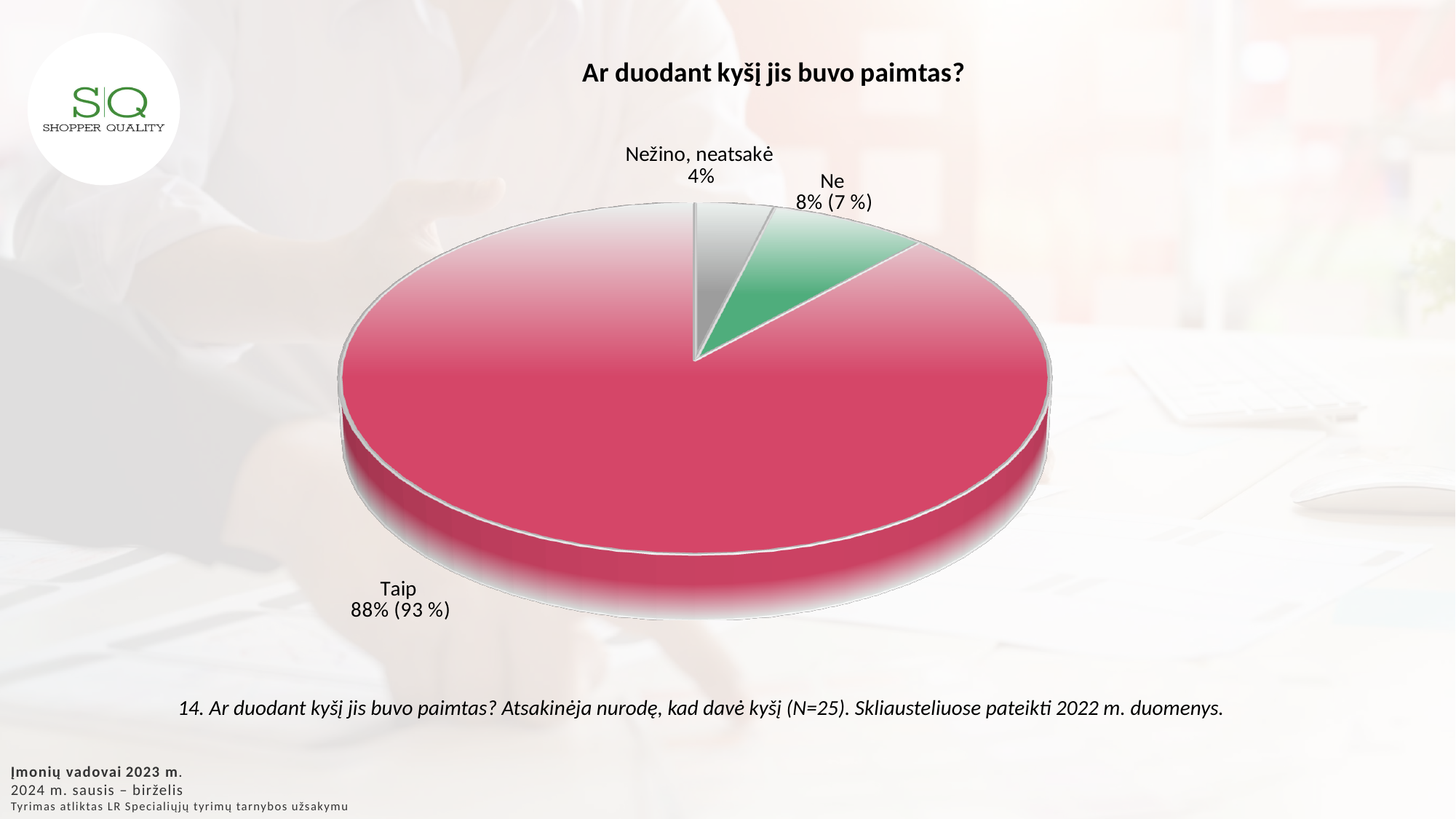
What is the title of the chart? Ar duodant kyšį jis buvo paimtas? What 2022 value is given in parentheses for "Ne"? 7 % What percentage is shown for the "Ne" slice? 8% What type of chart is shown on the slide? pie chart What 2022 value is given in parentheses for "Taip"? 93 % What is the difference in percentage points between the "Taip" and "Ne" slices? 80 What percentage is shown for the "Taip" slice? 88% How many slices does the pie chart have? 3 What percentage is shown for the "Nežino, neatsakė" slice? 4% Which is larger, the "Ne" slice or the "Nežino, neatsakė" slice? Ne Which slice of the pie is the largest? Taip Which slice of the pie is the smallest? Nežino, neatsakė